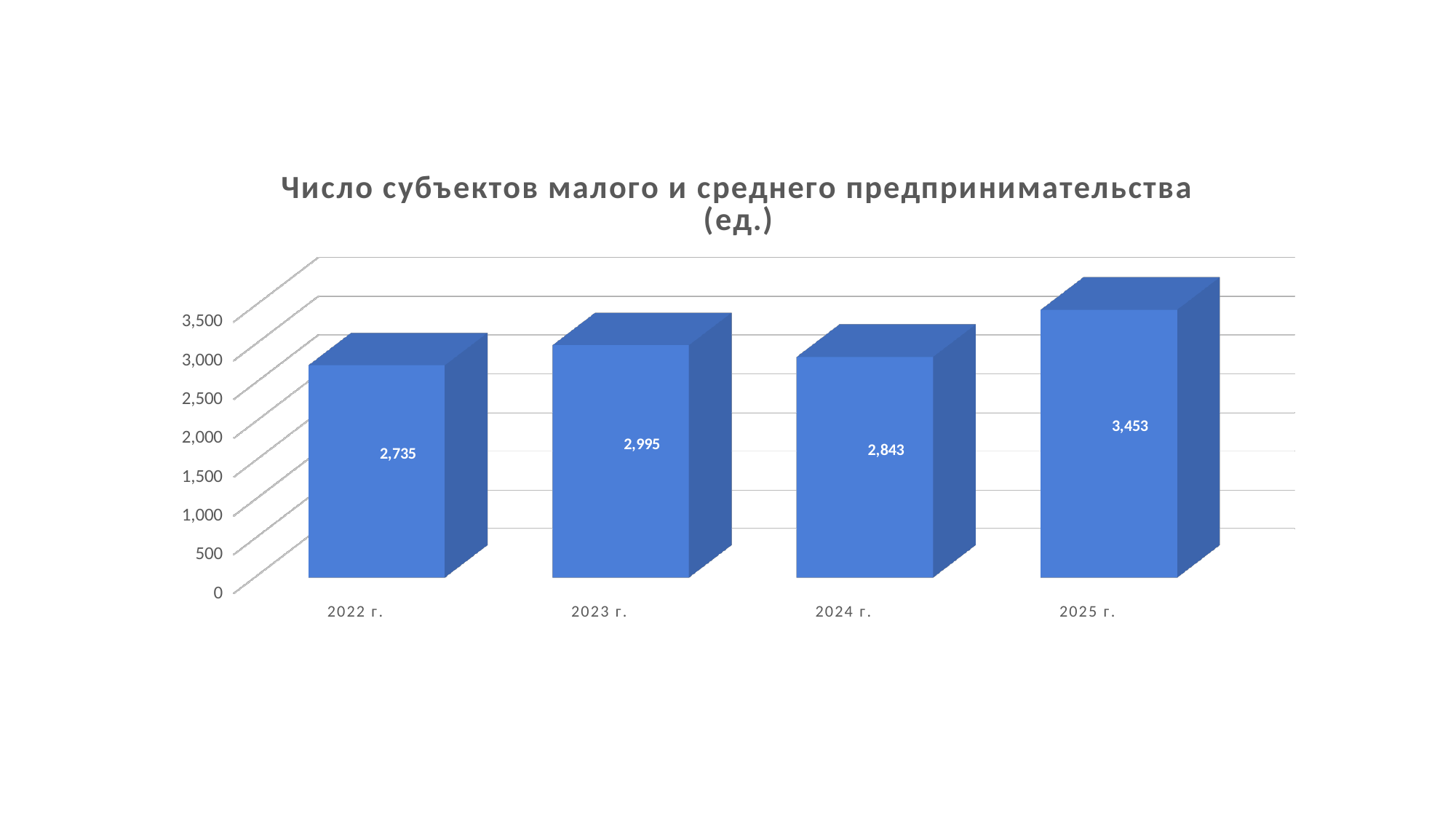
What is the value for 2025 г.? 3,453 What is the difference between the values for 2025 г. and 2022 г.? 718 Which year has the lowest value? 2022 г. What is the difference between the values for 2023 г. and 2024 г.? 152 What is the value for 2024 г.? 2,843 What is the value for 2022 г.? 2,735 What is the value for 2023 г.? 2,995 How many years are shown on the chart? 4 What is the title of the chart? Число субъектов малого и среднего предпринимательства (ед.) Which is larger, the value for 2023 г. or the value for 2024 г.? 2023 г. Which year has the highest value? 2025 г. What kind of chart is this? bar chart